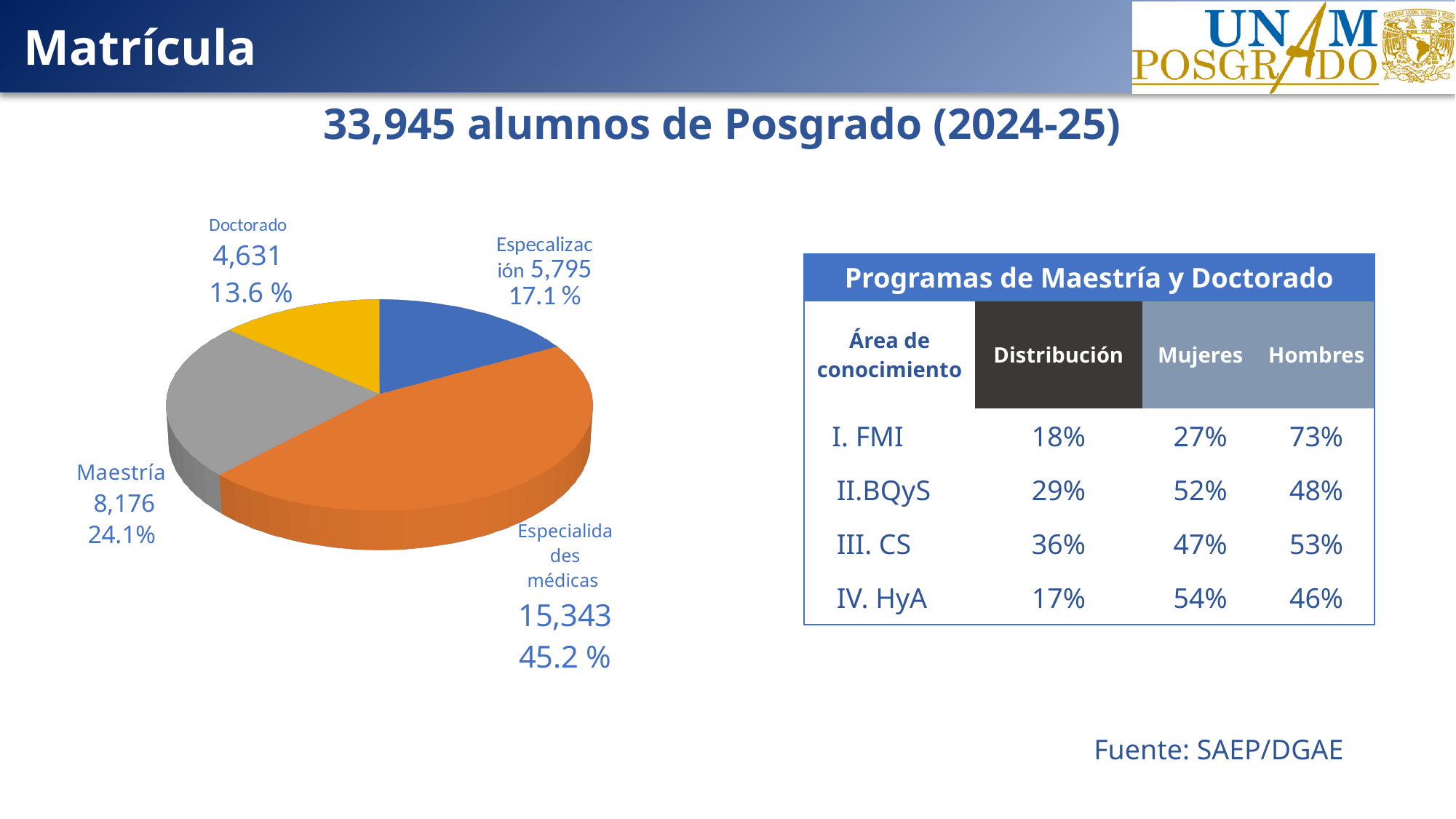
Which category has the smallest slice in the pie chart? Doctorado What is the difference in students between Maestría and Doctorado in the pie chart? 3,545 What percentage share does Especialización have in the pie chart? 17.1 % What is the number of students shown for Especialidades médicas in the pie chart? 15,343 What is the number of students shown for Doctorado in the pie chart? 4,631 What percentage share does Especialidades médicas have in the pie chart? 45.2 % What is the number of students shown for Maestría in the pie chart? 8,176 Which category has the largest slice in the pie chart? Especialidades médicas What colour is the Doctorado slice in the pie chart? yellow Which has more students in the pie chart, Especialización or Maestría? Maestría How many slices does the pie chart have? 4 What kind of chart is shown on the slide? pie chart